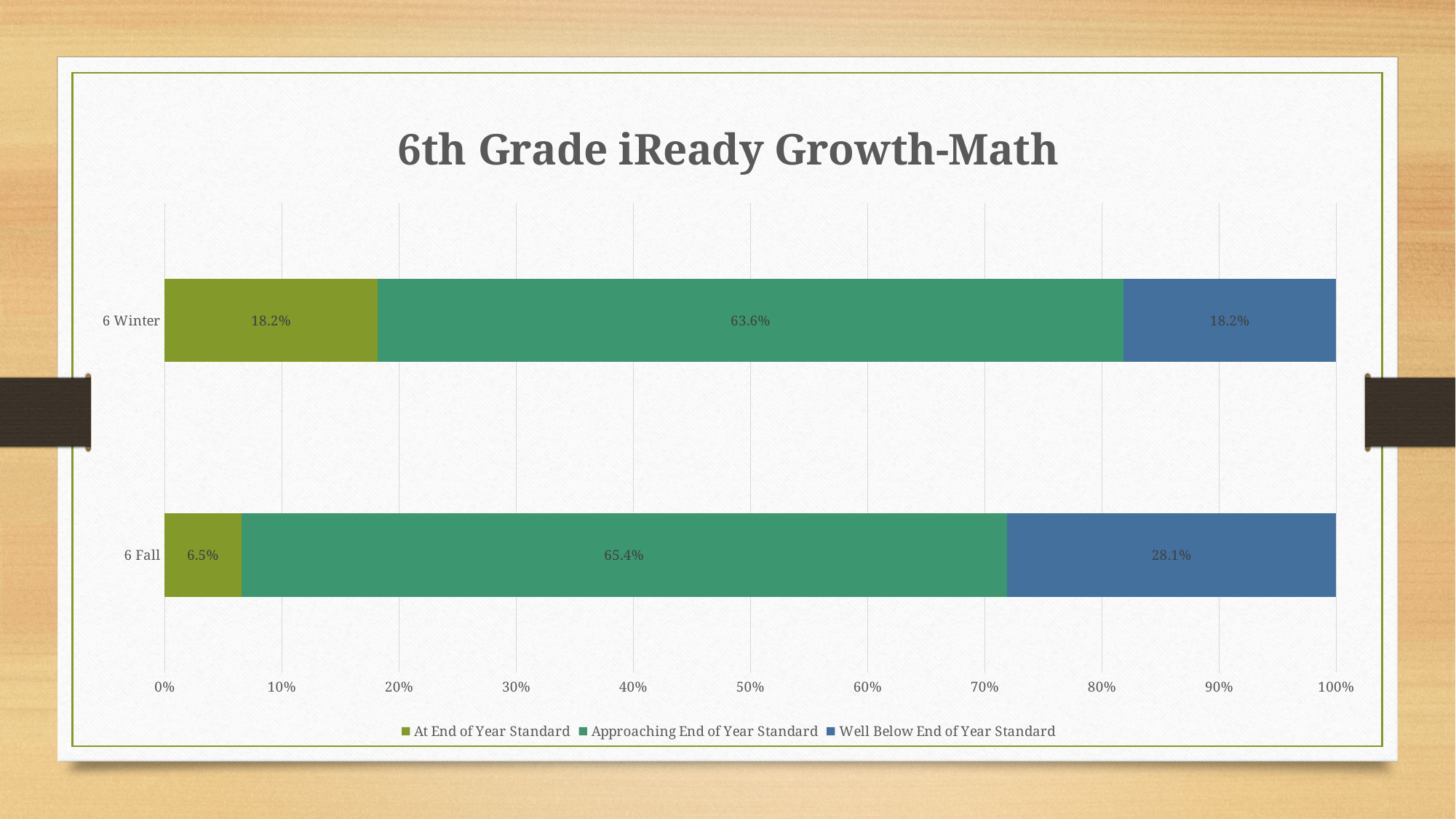
What is the difference between the Well Below End of Year Standard values for 6 Fall and 6 Winter? 9.9% How many series does the legend list? 3 What is the difference between the At End of Year Standard values for 6 Winter and 6 Fall? 11.7% What is the value for At End of Year Standard in 6 Winter? 18.2% What kind of chart is shown on the slide? Stacked bar chart Which series has the largest value in the 6 Fall bar? Approaching End of Year Standard Which series has the smallest value in the 6 Fall bar? At End of Year Standard What is the value for Well Below End of Year Standard in 6 Fall? 28.1% Which category has the higher value for At End of Year Standard, 6 Winter or 6 Fall? 6 Winter What is the value for Approaching End of Year Standard in 6 Fall? 65.4% What is the value for Well Below End of Year Standard in 6 Winter? 18.2% How many categories are shown on the chart? 2